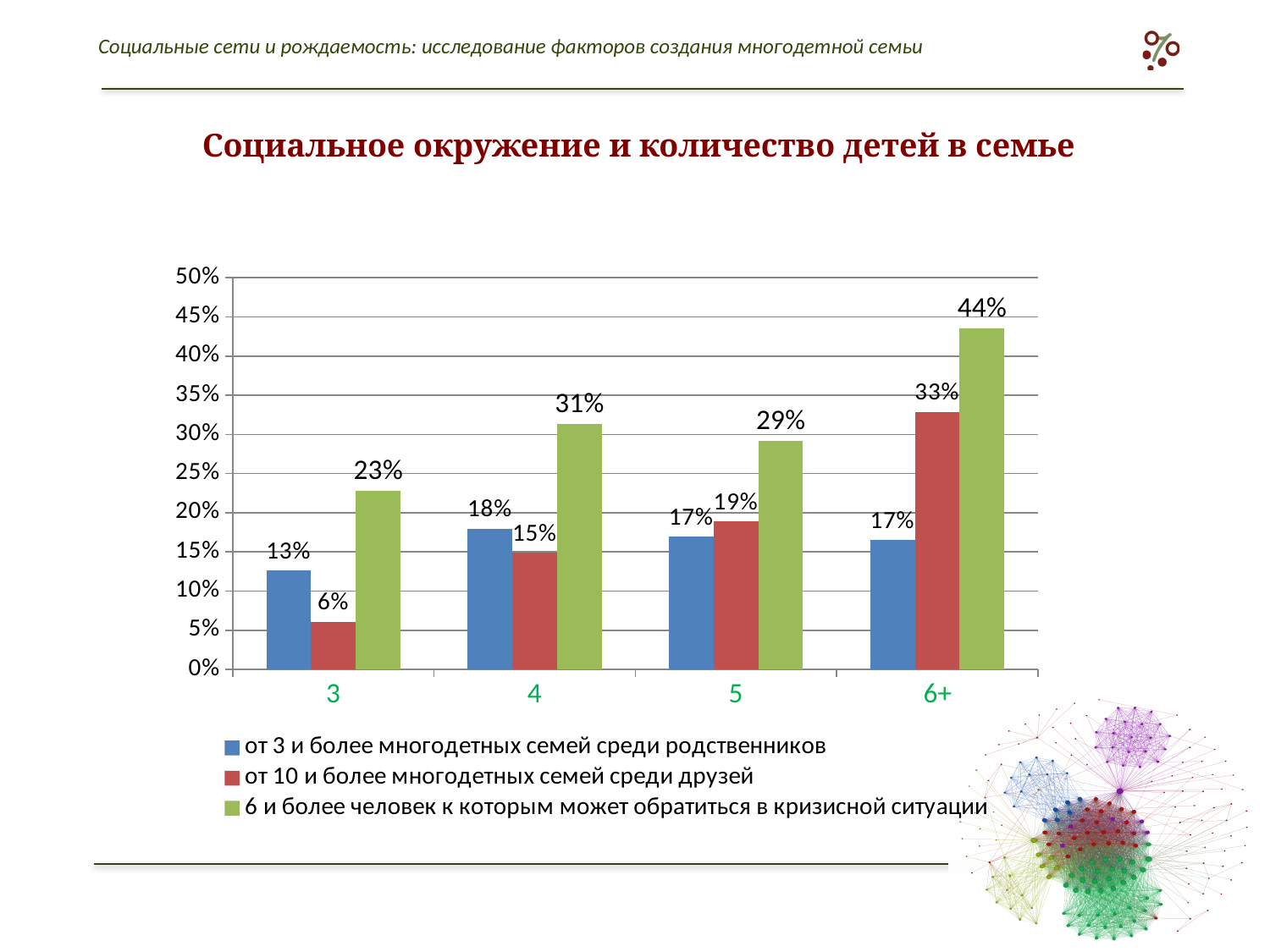
What is the difference between the values for '6 и более человек к которым может обратиться в кризисной ситуации' in categories 6+ and 3? 21% In which category is the value for '6 и более человек к которым может обратиться в кризисной ситуации' lowest? 3 What type of chart is shown on the slide? bar chart What is the value for 'от 3 и более многодетных семей среди родственников' in category 4? 18% Does the value for 'от 10 и более многодетных семей среди друзей' rise or fall as the number of children increases from 3 to 6+? rise What colour represents 'от 3 и более многодетных семей среди родственников' in the chart? blue Which is larger in category 5: 'от 3 и более многодетных семей среди родственников' or 'от 10 и более многодетных семей среди друзей'? от 10 и более многодетных семей среди друзей In which category is the value for 'от 10 и более многодетных семей среди друзей' highest? 6+ How many series does the legend list? 3 What is the value for 'от 10 и более многодетных семей среди друзей' in category 3? 6% How many categories are shown on the x axis? 4 What is the value for '6 и более человек к которым может обратиться в кризисной ситуации' in category 6+? 44%